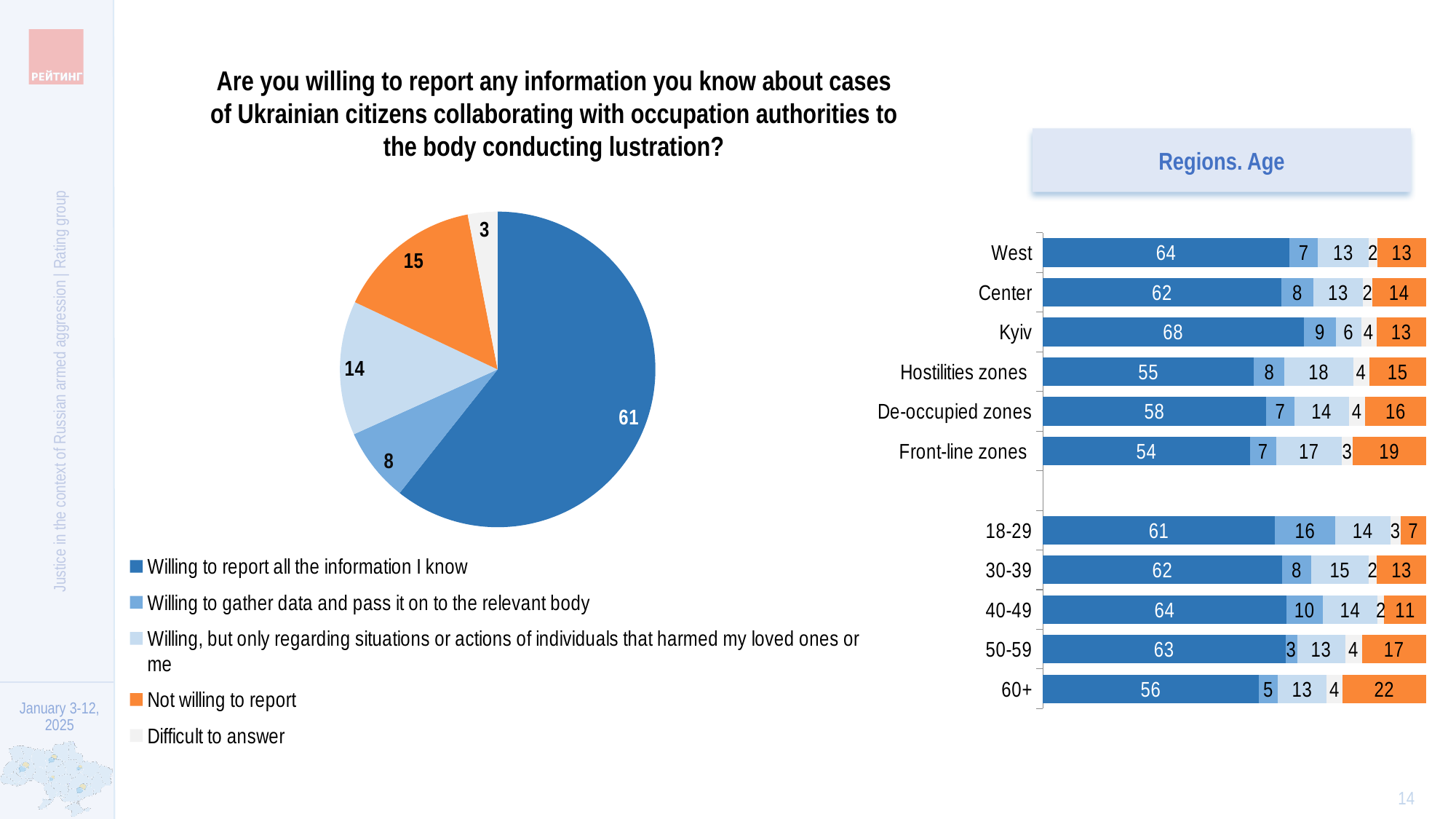
In the pie chart on the left, what is the difference between 'Not willing to report' and 'Willing to gather data and pass it on to the relevant body'? 7 In the pie chart on the left, which response has the largest slice? Willing to report all the information I know What kind of chart is the chart on the left? Pie chart In the 'Regions. Age' chart, what is the value for 'Willing to report all the information I know' in Kyiv? 68 In the 'Regions. Age' chart, what is the value for 'Not willing to report' among respondents aged 60+? 22 In the pie chart on the left, what is the value for 'Difficult to answer'? 3 In the pie chart on the left, what share of respondents are willing to report all the information they know? 61 In the 'Regions. Age' chart, which region has the lowest value for 'Willing to report all the information I know'? Front-line zones In the 'Regions. Age' chart, is the 'Not willing to report' value larger for Front-line zones or for West? Front-line zones How many entries does the legend of the pie chart on the left list? 5 In the 'Regions. Age' chart, which age group has the highest value for 'Willing to gather data and pass it on to the relevant body'? 18-29 What kind of chart is the 'Regions. Age' chart? Stacked bar chart